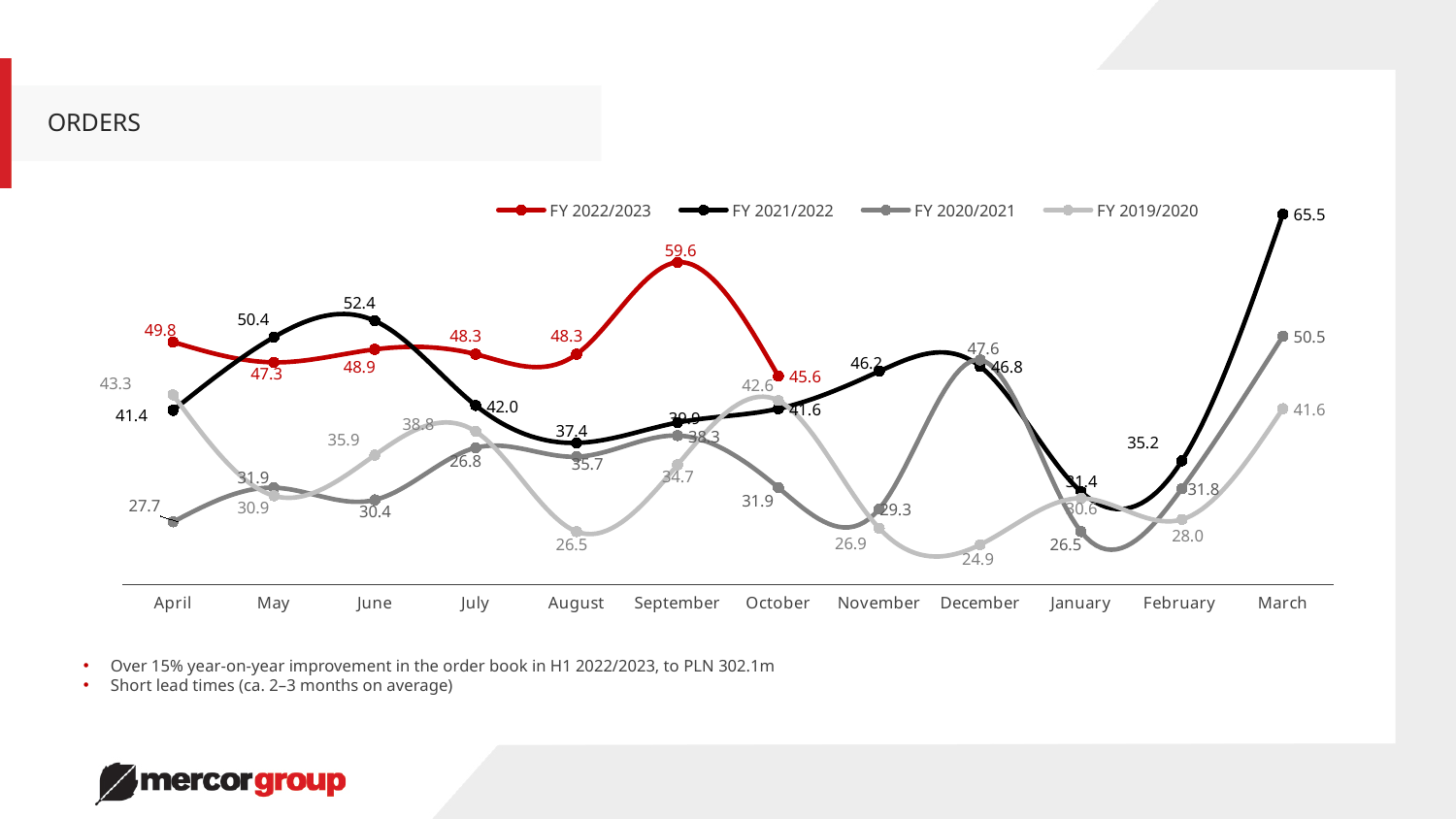
In which month does the FY 2021/2022 series reach its highest value? March How many series does the legend of the ORDERS chart list? 4 What is the difference between the FY 2022/2023 values for September and October? 14.0 In which month does the FY 2022/2023 series reach its highest value? September What is the FY 2020/2021 value for December? 47.6 In which month does the FY 2019/2020 series have its lowest value? December What kind of chart is shown on the ORDERS slide? line chart What is the FY 2022/2023 value for September? 59.6 How many months are shown on the x axis of the ORDERS chart? 12 In April, which series has the larger value: FY 2022/2023 or FY 2021/2022? FY 2022/2023 What is the FY 2021/2022 value for March? 65.5 What colour is the FY 2022/2023 line in the ORDERS chart? red